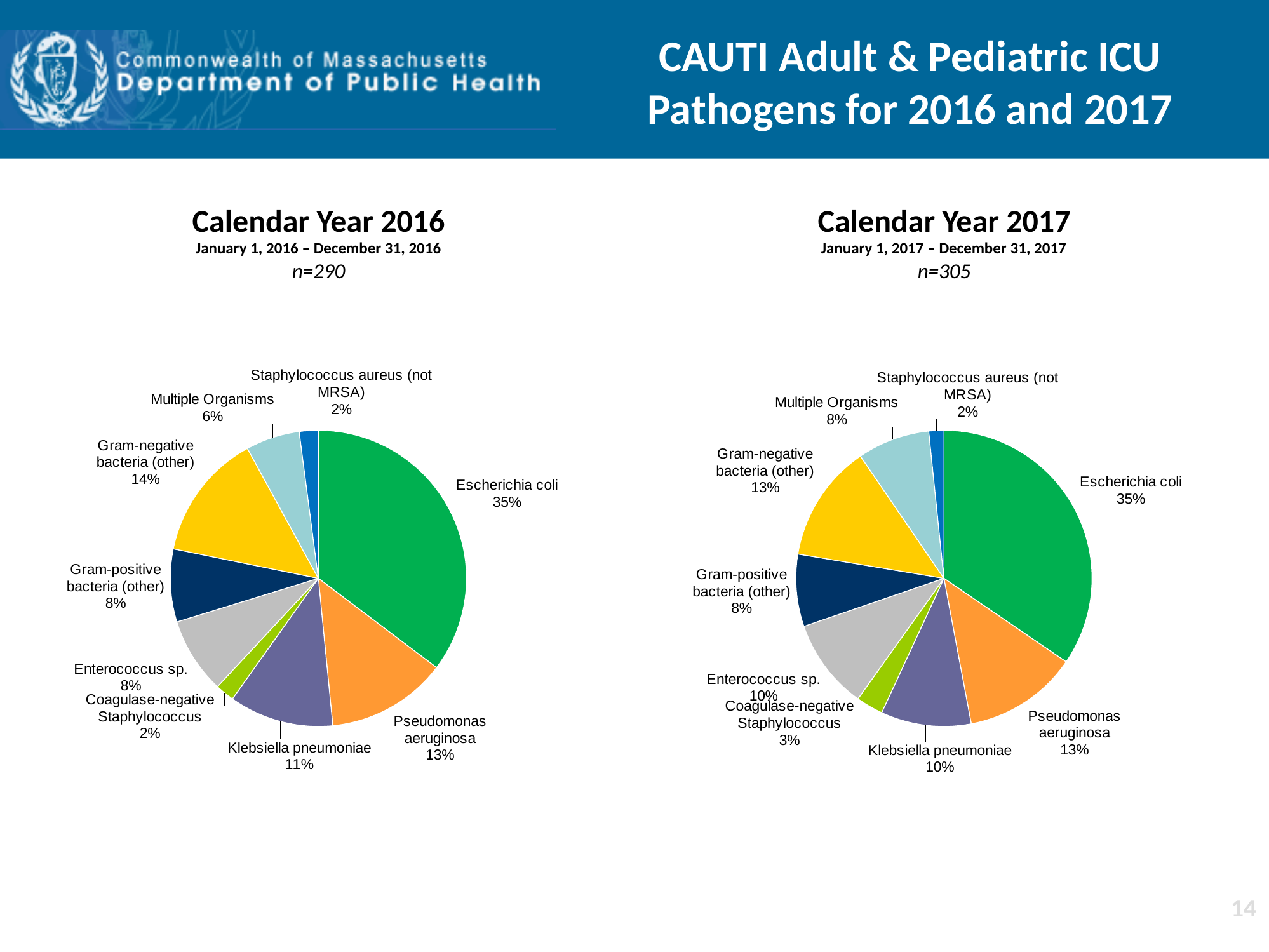
In the Calendar Year 2017 pie chart, what share is Klebsiella pneumoniae? 10% In the Calendar Year 2016 pie chart, what is the difference between the shares for Gram-negative bacteria (other) and Multiple Organisms? 8% In the Calendar Year 2016 pie chart, what share is Coagulase-negative Staphylococcus? 2% In the Calendar Year 2017 pie chart, what share is Multiple Organisms? 8% In the Calendar Year 2017 pie chart, which pathogen has the smallest share? Staphylococcus aureus (not MRSA) How many slices does the Calendar Year 2016 pie chart have? 9 What is the n value shown for the Calendar Year 2017 chart? n=305 What is the date range shown under the Calendar Year 2016 chart title? January 1, 2016 – December 31, 2016 In the Calendar Year 2016 pie chart, which pathogen has the largest share? Escherichia coli In the Calendar Year 2017 pie chart, which is larger: Enterococcus sp. or Gram-positive bacteria (other)? Enterococcus sp. What type of chart is used for Calendar Year 2017? Pie chart